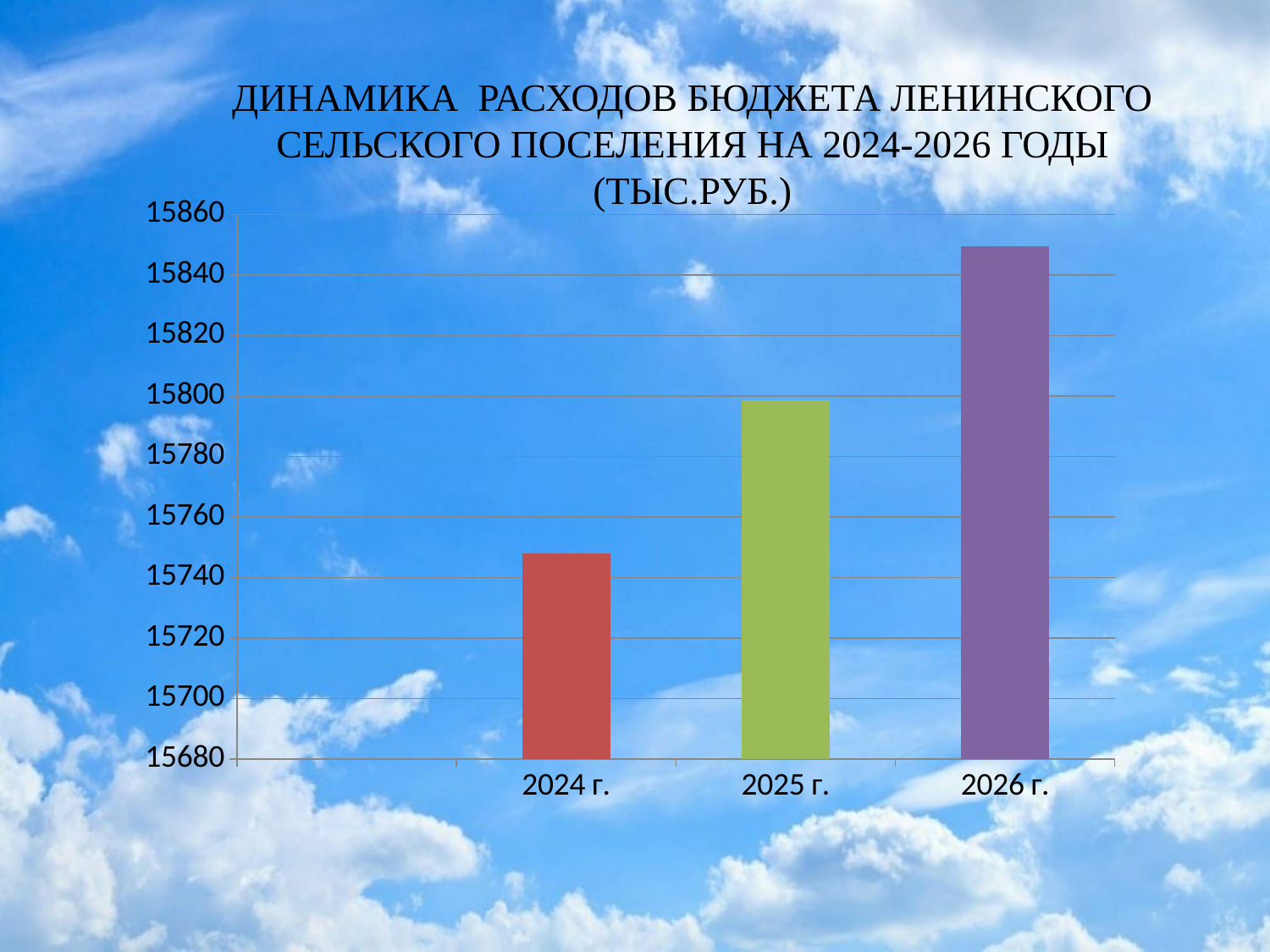
Is the value for 2026 г. greater or less than 15840? greater What unit of measurement is stated in the chart title? ТЫС.РУБ. How many categories (years) are plotted on the chart? 3 Which year has the highest budget expenditure on the chart? 2026 г. Is the value for 2026 г. greater or less than 15860? less What kind of chart is shown on the slide? bar chart Which year has the lowest budget expenditure on the chart? 2024 г. Is the value for 2024 г. greater or less than 15740? greater Which is larger, the value for 2025 г. or the value for 2024 г.? 2025 г. Do the values rise or fall from 2024 to 2026 along the x axis? rise